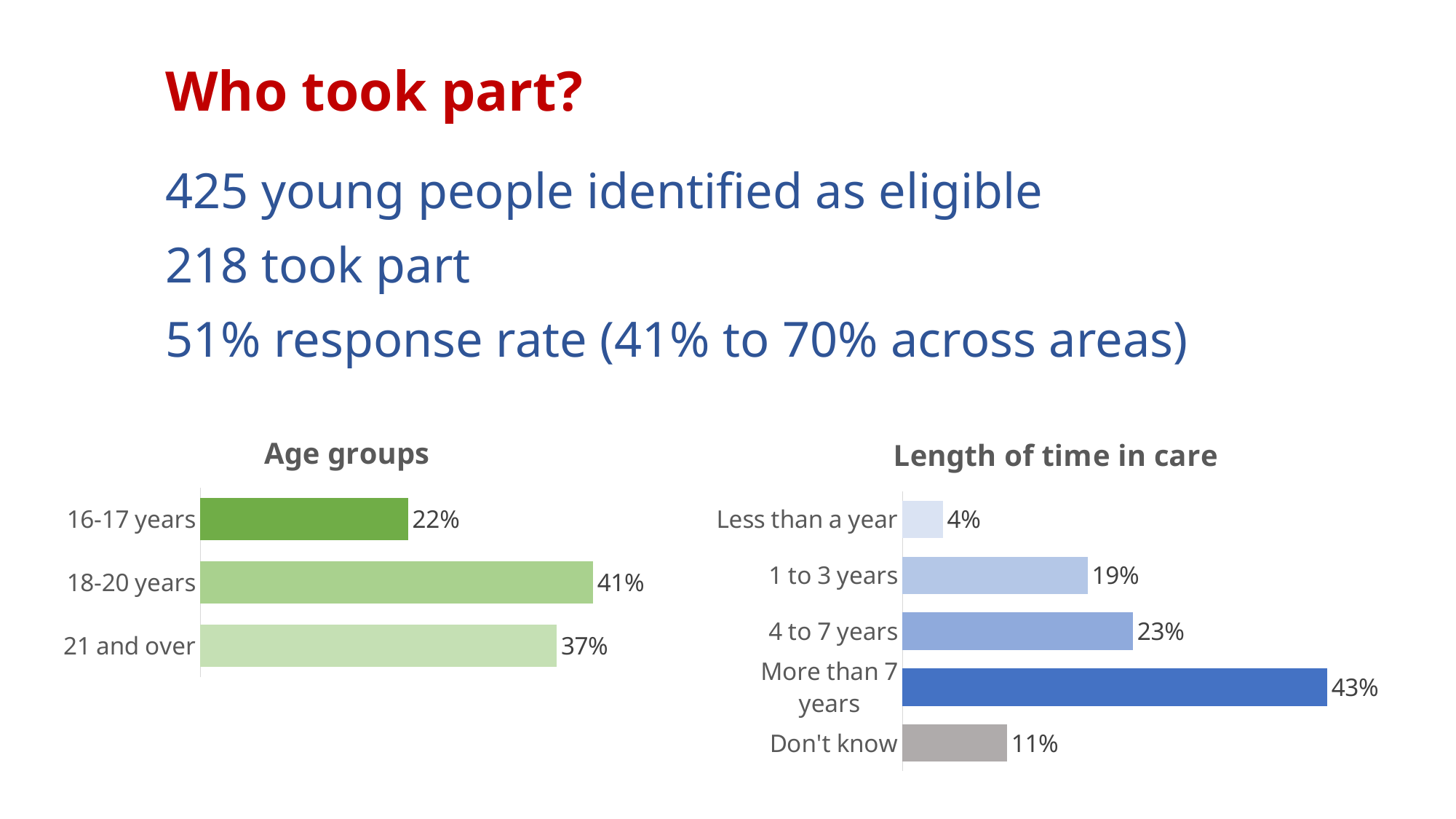
In the 'Age groups' chart, how many age groups are shown? 3 In the 'Length of time in care' chart, which category has the lowest value? Less than a year In the 'Length of time in care' chart, how many categories are shown? 5 What kind of chart is the 'Age groups' chart? Bar chart In the 'Age groups' chart, what is the difference between the values for 18-20 years and 21 and over? 4% In the 'Length of time in care' chart, what colour is the bar for Don't know? Grey In the 'Length of time in care' chart, which category has the highest value? More than 7 years In the 'Age groups' chart, what is the value for 18-20 years? 41% In the 'Length of time in care' chart, what is the difference between the values for More than 7 years and 1 to 3 years? 24% In the 'Age groups' chart, which age group has the lowest value? 16-17 years In the 'Length of time in care' chart, what is the value for 4 to 7 years? 23% In the 'Length of time in care' chart, which is larger: the value for 1 to 3 years or the value for Don't know? 1 to 3 years